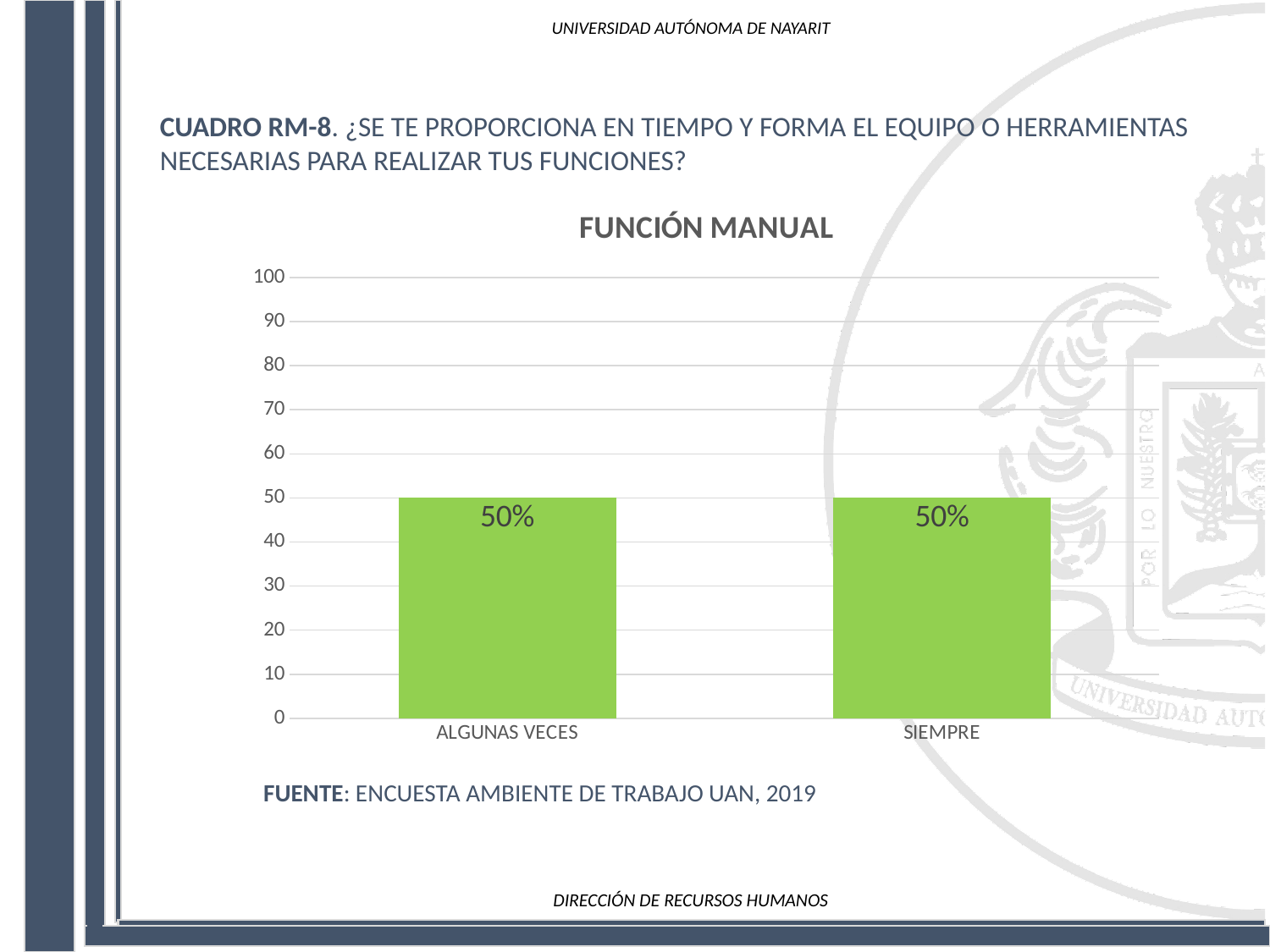
What is the value for ALGUNAS VECES? 50% What kind of chart is shown on the slide? bar chart What is the title of the chart? FUNCIÓN MANUAL Is the value for ALGUNAS VECES greater or less than 40? greater How many categories are shown on the x axis? 2 Is the value for SIEMPRE greater or less than 60? less What is the difference between the values for ALGUNAS VECES and SIEMPRE? 0 What is the value for SIEMPRE? 50% What colour are the bars in the chart? green What is the total of the two values shown in the chart? 100% What is the highest value shown on the y axis? 100